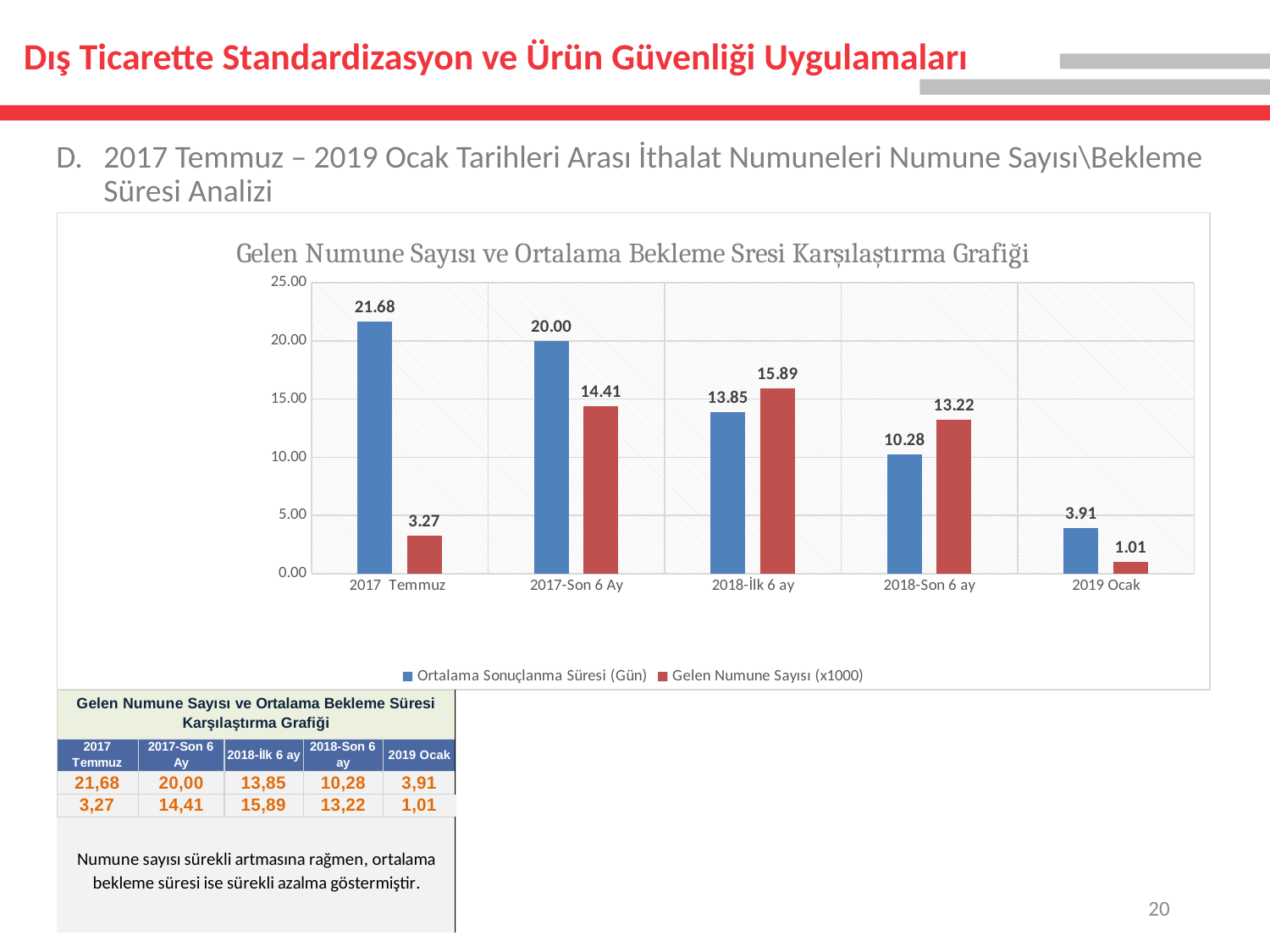
How many categories are shown on the x axis of the chart? 5 For 2018-Son 6 ay, which series has the larger value: Ortalama Sonuçlanma Süresi (Gün) or Gelen Numune Sayısı (x1000)? Gelen Numune Sayısı (x1000) Does the Ortalama Sonuçlanma Süresi (Gün) series rise or fall from 2017 Temmuz to 2019 Ocak? Fall What kind of chart is shown on the slide? Bar chart What is the value of Gelen Numune Sayısı (x1000) for 2018-İlk 6 ay? 15.89 Which category has the highest value for Ortalama Sonuçlanma Süresi (Gün)? 2017 Temmuz What is the value of Gelen Numune Sayısı (x1000) for 2019 Ocak? 1.01 How many series does the chart legend list? 2 Is the value of Ortalama Sonuçlanma Süresi (Gün) for 2017-Son 6 Ay greater or less than 15.00? greater What is the difference between Ortalama Sonuçlanma Süresi (Gün) and Gelen Numune Sayısı (x1000) for 2017 Temmuz? 18.41 What is the value of Ortalama Sonuçlanma Süresi (Gün) for 2017 Temmuz? 21.68 Which category has the lowest value for Gelen Numune Sayısı (x1000)? 2019 Ocak